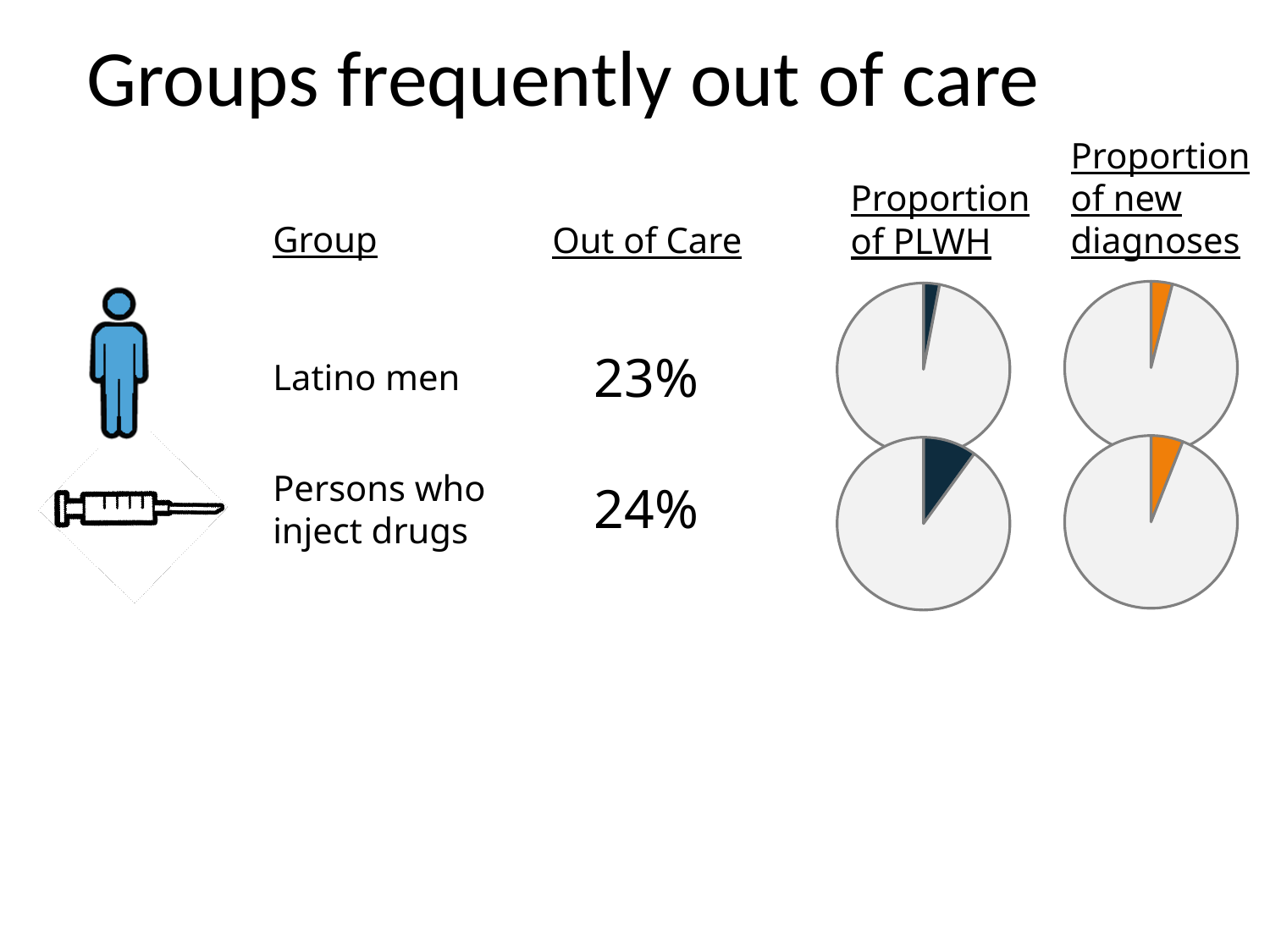
For persons who inject drugs, which pie chart has the larger highlighted slice, Proportion of PLWH or Proportion of new diagnoses? Proportion of PLWH Is the highlighted slice in the Proportion of PLWH pie chart for persons who inject drugs greater or less than 50% of the pie? less In the Proportion of PLWH pie charts, which group has the larger highlighted slice, Latino men or persons who inject drugs? Persons who inject drugs What kind of chart is used to show the Proportion of PLWH for Latino men? Pie chart What colour is the highlighted slice in the Proportion of PLWH pie charts? Dark blue How many pie charts are shown on the slide? 4 In the Proportion of new diagnoses pie charts, which group has the larger highlighted slice, Latino men or persons who inject drugs? Persons who inject drugs How many slices does each pie chart on the slide have? 2 What colour is the highlighted slice in the Proportion of new diagnoses pie charts? Orange